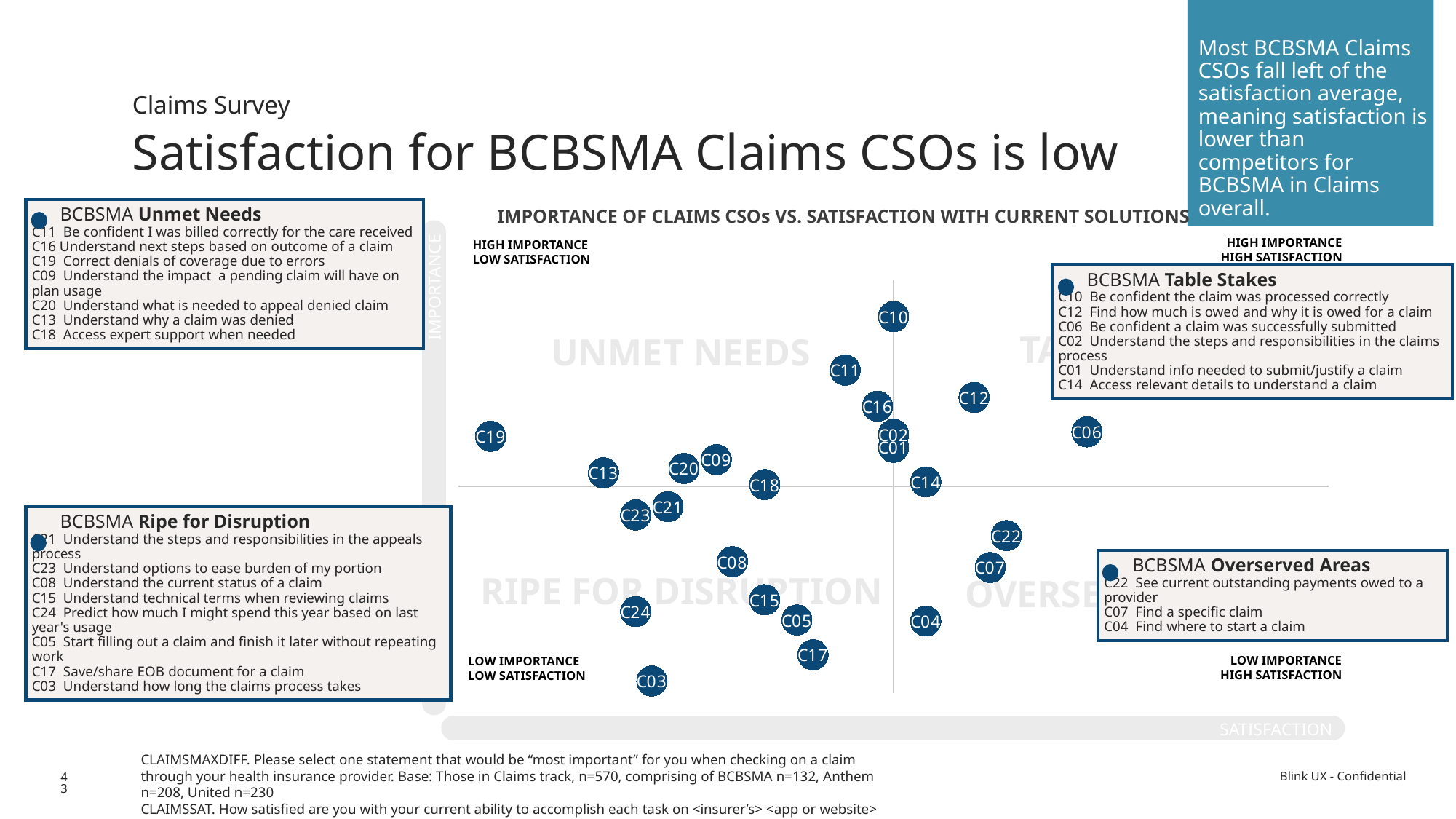
How many data points are plotted on the chart? 24 What does the horizontal axis of the chart represent? Satisfaction Which has higher importance, C11 or C04? C11 Which point has the lowest satisfaction on the chart? C19 Which has higher satisfaction, C19 or C12? C12 Which has higher satisfaction, C22 or C24? C22 Which point has the highest satisfaction on the chart? C06 Which point has the highest importance on the chart? C10 Which point has the lowest importance on the chart? C03 What is the title of the chart? Importance of Claims CSOs vs. Satisfaction with Current Solutions What kind of chart is shown on the slide? scatter chart